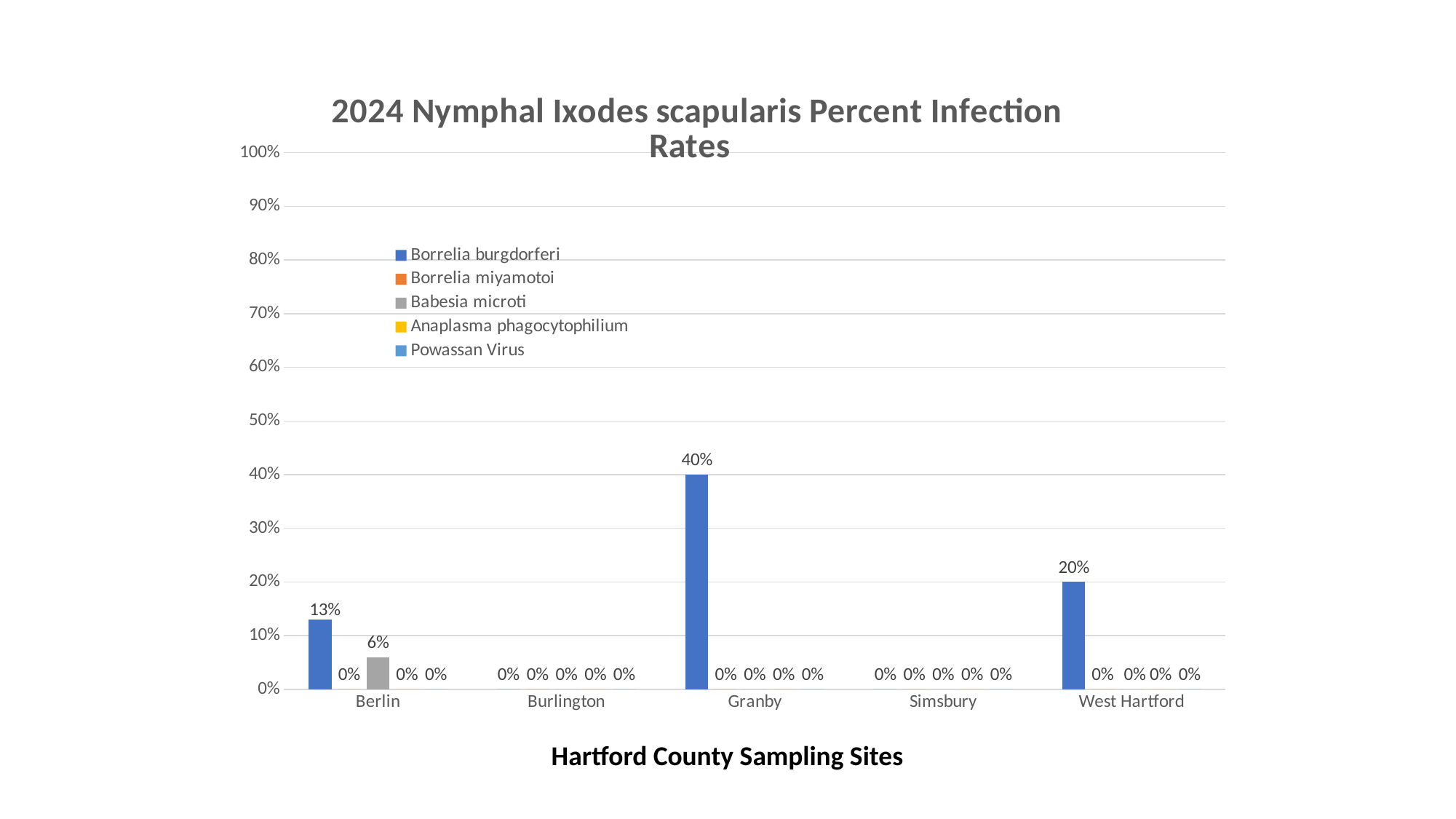
How many series does the legend list? 5 Is the Borrelia burgdorferi rate at Granby greater or less than 30%? greater What is the difference between the Borrelia burgdorferi infection rates at Granby and West Hartford? 20% What is the Borrelia burgdorferi infection rate at West Hartford? 20% What is the Babesia microti infection rate at Berlin? 6% Which sampling site has the highest Borrelia burgdorferi infection rate? Granby What is the Borrelia burgdorferi infection rate at Berlin? 13% What is the x-axis title of the chart? Hartford County Sampling Sites How many sampling sites are shown on the x axis? 5 What kind of chart is shown on the slide? Bar chart Which is larger, the Borrelia burgdorferi rate at Berlin or at West Hartford? West Hartford What is the Borrelia burgdorferi infection rate at Granby? 40%